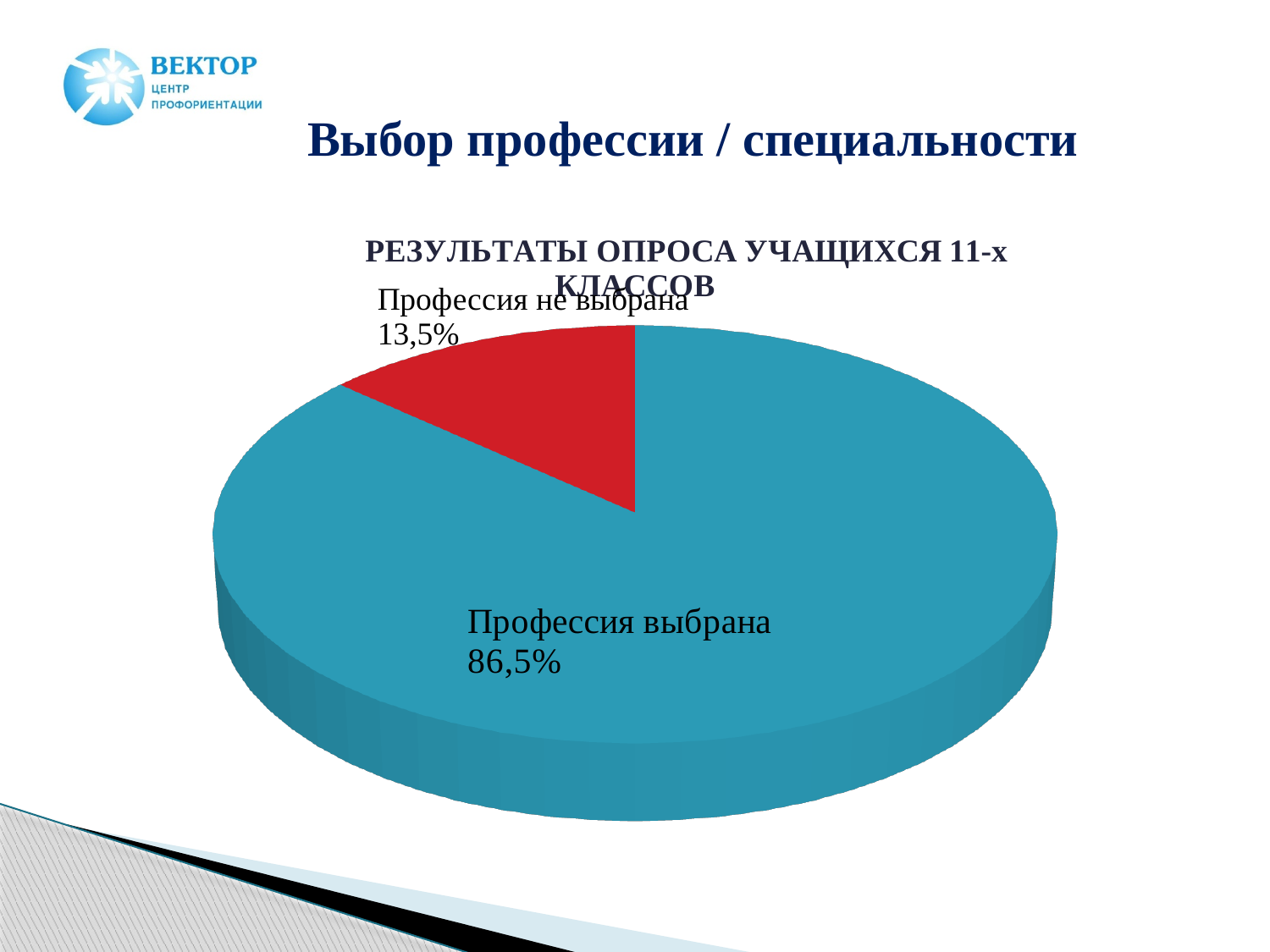
How many categories are shown in the pie chart? 2 What is the title of the chart? РЕЗУЛЬТАТЫ ОПРОСА УЧАЩИХСЯ 11-х КЛАССОВ Which category has the largest slice of the pie? Профессия выбрана What share of the pie does "Профессия выбрана" represent? 86,5% What share of the pie does "Профессия не выбрана" represent? 13,5% Is the share for "Профессия не выбрана" greater or less than 50%? less Which is larger: the share for "Профессия выбрана" or for "Профессия не выбрана"? Профессия выбрана What kind of chart is shown on the slide? pie chart Which category has the smallest slice of the pie? Профессия не выбрана What is the difference in percentage points between "Профессия выбрана" and "Профессия не выбрана"? 73 percentage points What colour is the slice for "Профессия не выбрана"? red